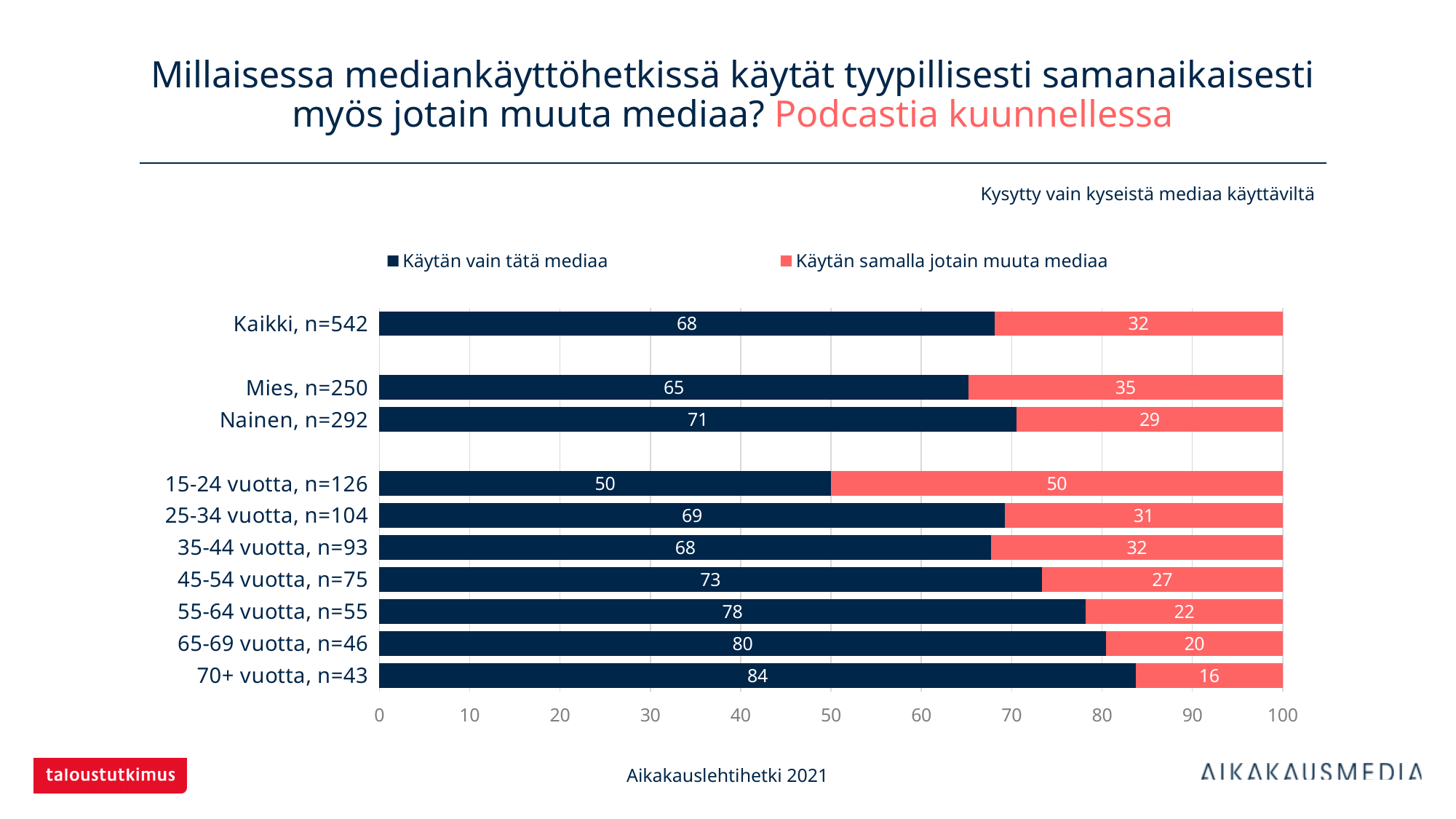
Which category has the lowest value for "Käytän samalla jotain muuta mediaa"? 70+ vuotta, n=43 Which series is shown in dark blue in the legend? Käytän vain tätä mediaa What is the total of the stacked bar for 45-54 vuotta, n=75? 100 What is the value of "Käytän samalla jotain muuta mediaa" for 15-24 vuotta, n=126? 50 What is the difference between the "Käytän vain tätä mediaa" values for Nainen, n=292 and Mies, n=250? 6 How many series does the legend list? 2 Which category has the highest value for "Käytän vain tätä mediaa"? 70+ vuotta, n=43 How many categories are shown on the y axis of the chart? 10 What is the value of "Käytän vain tätä mediaa" for Kaikki, n=542? 68 What kind of chart is shown on the slide? Stacked bar chart What is the value of "Käytän vain tätä mediaa" for Nainen, n=292? 71 Which has a larger "Käytän samalla jotain muuta mediaa" value: 25-34 vuotta, n=104 or 55-64 vuotta, n=55? 25-34 vuotta, n=104